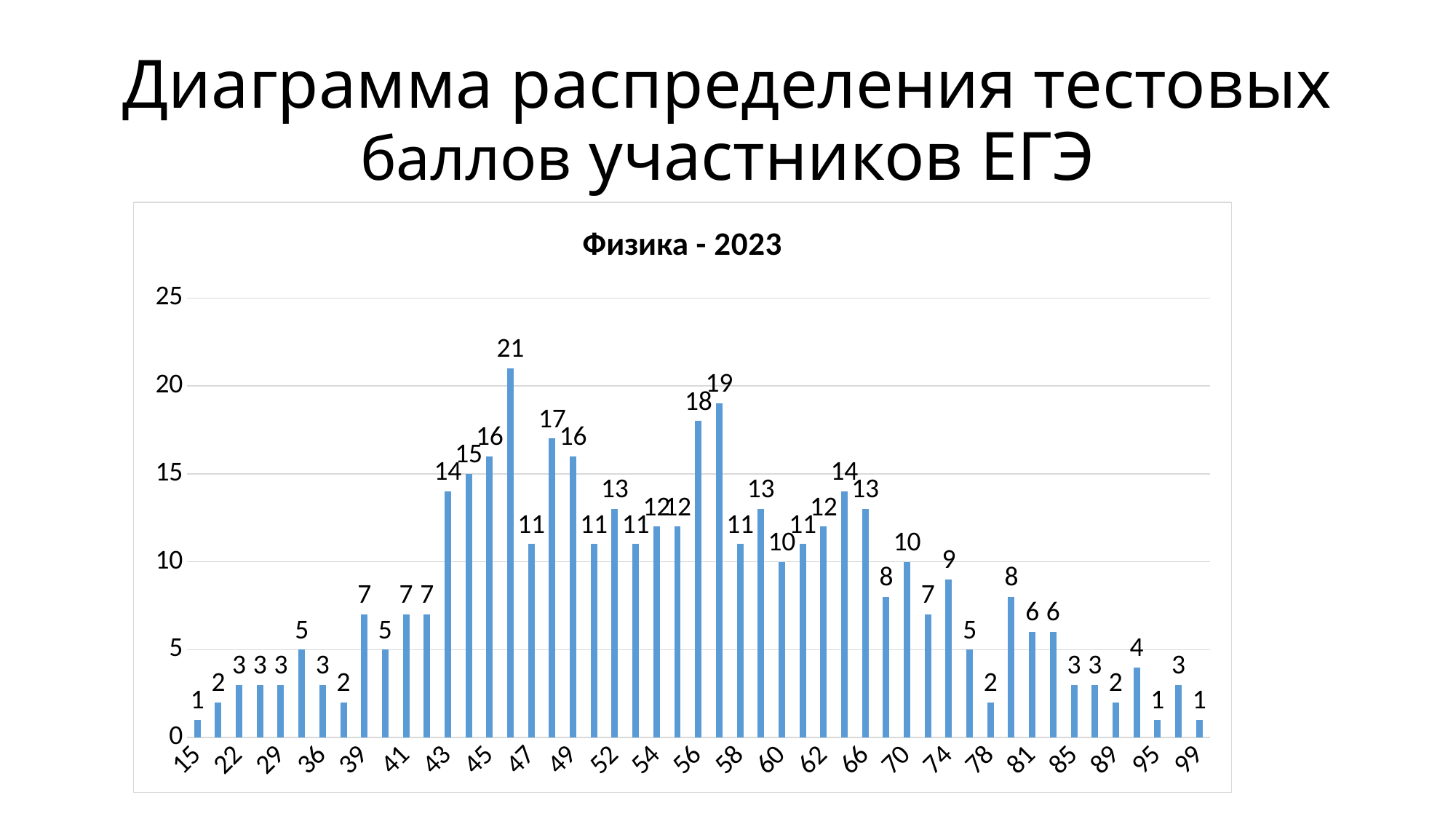
What is the title of the chart? Физика - 2023 What is the lowest value shown on the chart? 1 What is the difference between the values for scores 56 and 47? 7 What type of chart is shown on the slide? bar chart What is the highest value shown on the chart? 21 What is the value for the score 56? 18 How many bars are plotted on the chart? 49 What is the value for the score 74? 9 What is the value for the score 43? 14 Which has a larger value, score 49 or score 52? 49 What is the value for the score 99? 1 Is the value for score 56 greater or less than 15? greater